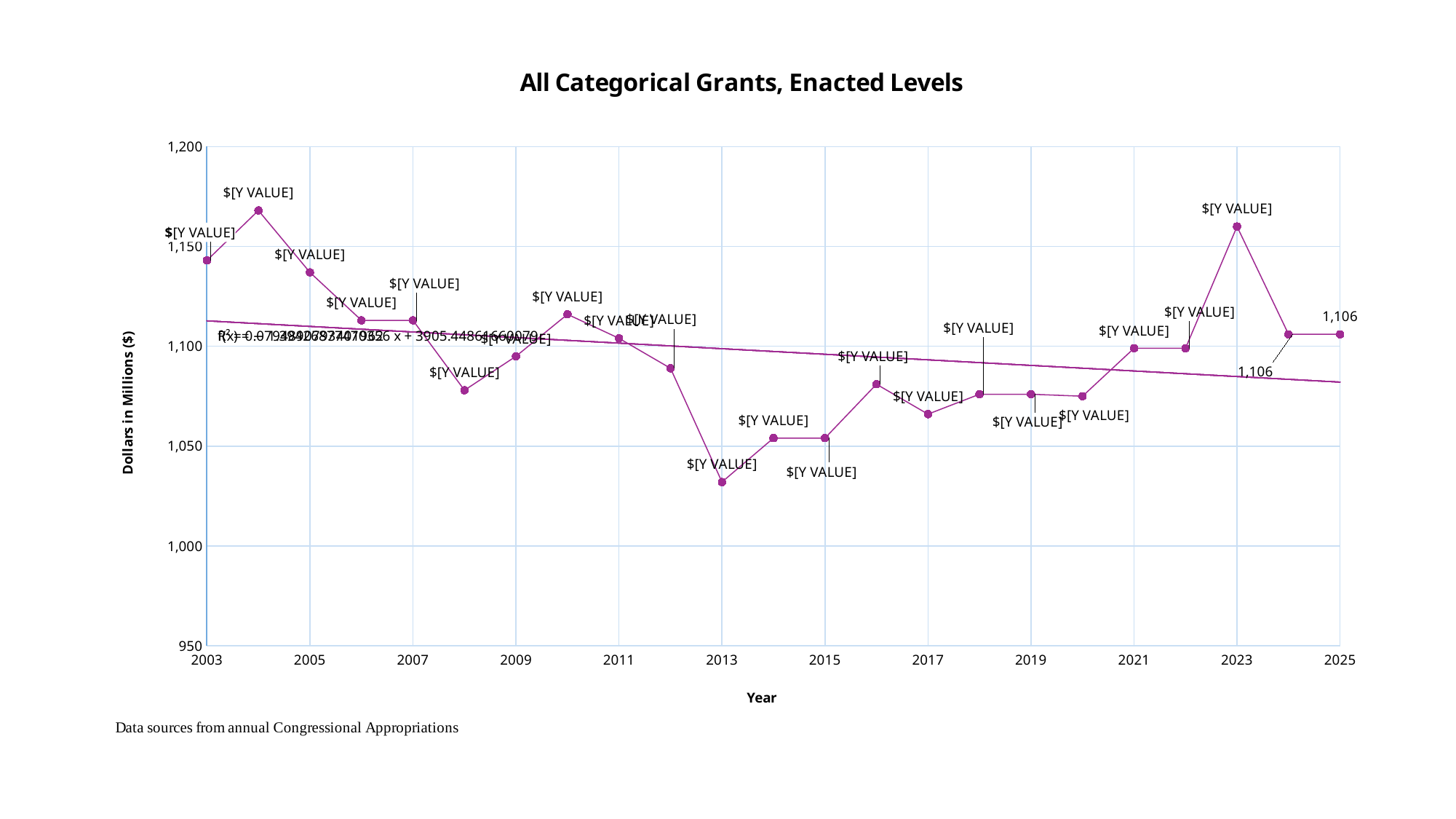
Which is larger, the value for 2010 or the value for 2013? 2010 Is the value for 2013 greater or less than 1,050? less How many years are plotted on the x axis from 2003 to 2025? 23 What type of chart is shown on the slide? line chart Is the value for 2004 greater or less than 1,150? greater What is the title of the chart? All Categorical Grants, Enacted Levels Is the value for 2023 greater or less than 1,150? greater Which year has the lowest value? 2013 What is the value for 2024? 1,106 What is the label on the vertical axis of the chart? Dollars in Millions ($) What is the value for 2025? 1,106